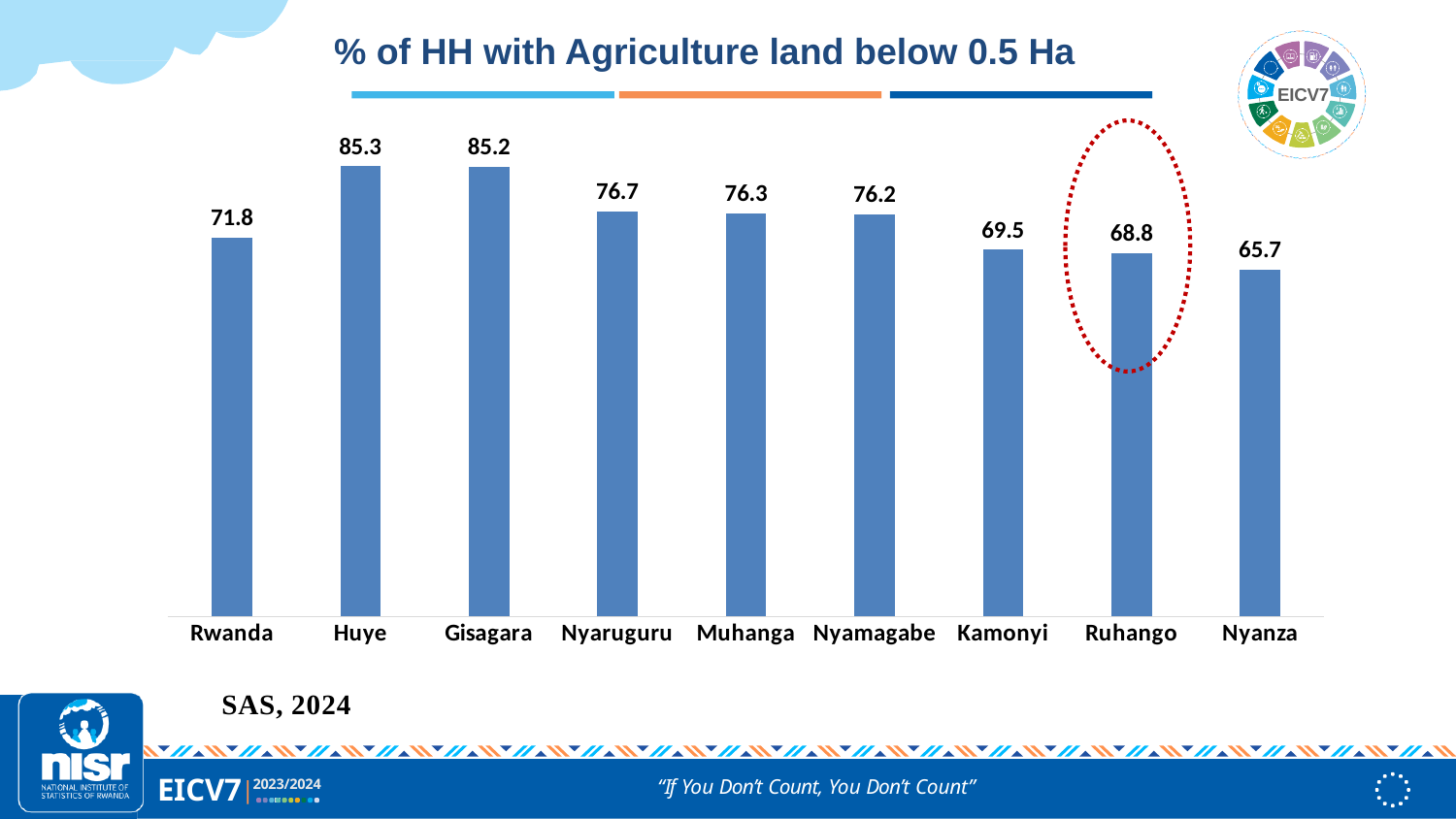
Which is larger, the value for Kamonyi or the value for Nyaruguru? Nyaruguru What is the value for Rwanda? 71.8 What is the value for Ruhango? 68.8 What kind of chart is this? Bar chart Which category is highlighted with a red dotted circle? Ruhango What is the value for Huye? 85.3 What is the title of the chart? % of HH with Agriculture land below 0.5 Ha How many categories are shown on the x axis? 9 What is the difference between the values for Gisagara and Nyanza? 19.5 What is the difference between the values for Huye and Ruhango? 16.5 What is the value for Nyamagabe? 76.2 Which category has the lowest value? Nyanza